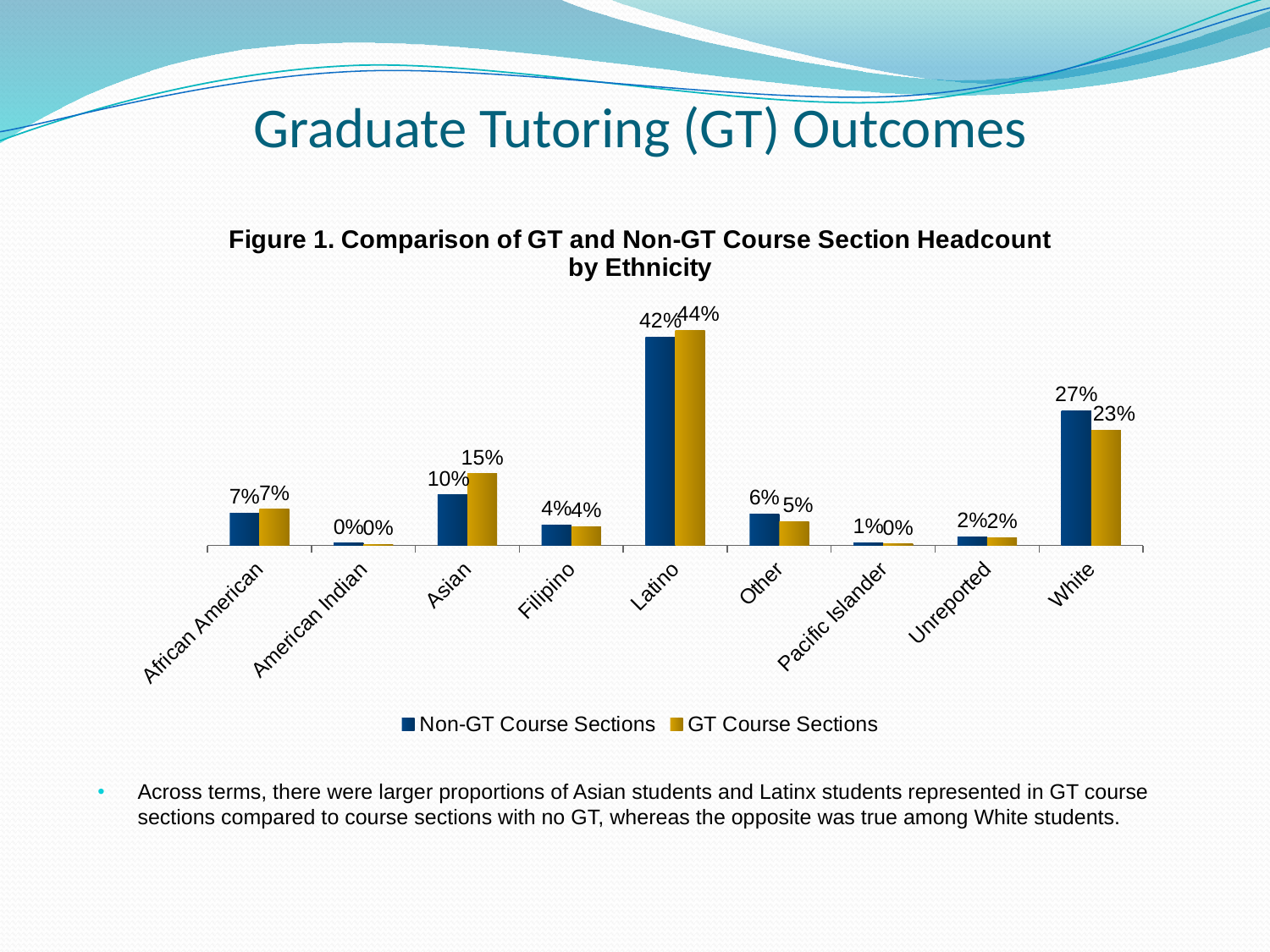
For White, which is larger: the Non-GT Course Sections value or the GT Course Sections value? Non-GT Course Sections What is the GT Course Sections value for Latino? 44% What is the GT Course Sections value for Asian? 15% How many ethnicity categories are shown on the x axis? 9 Which ethnicity has the highest GT Course Sections value? Latino What is the Non-GT Course Sections value for White? 27% What kind of chart is shown? Bar chart How many series does the legend list? 2 What is the Non-GT Course Sections value for Other? 6% What is the difference between the Non-GT and GT Course Sections values for White? 4% What is the difference between the GT and Non-GT Course Sections values for Asian? 5% What is the title of the figure? Figure 1. Comparison of GT and Non-GT Course Section Headcount by Ethnicity